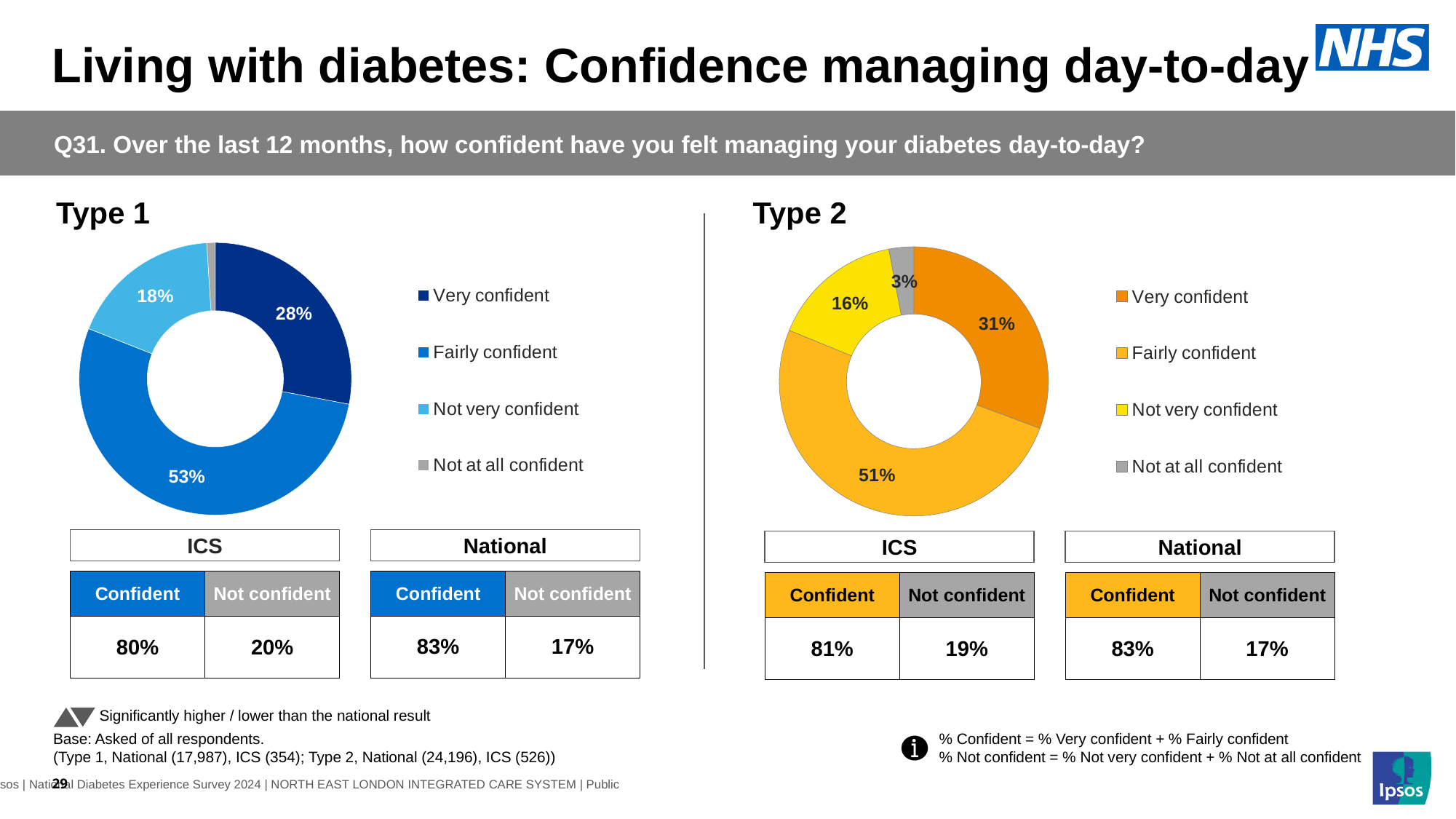
In the Type 1 chart, which category has the largest share? Fairly confident How many categories does the legend of the Type 1 chart list? 4 In the Type 1 chart, what percentage of respondents were Fairly confident? 53% In the Type 2 chart, what percentage of respondents were Not very confident? 16% In the Type 1 chart, what is the difference between the Fairly confident and Very confident shares? 25 percentage points In the Type 2 chart, which category has the largest share? Fairly confident Is the Very confident share larger in the Type 1 chart or the Type 2 chart? Type 2 What kind of chart is used to show the Type 2 results? Doughnut (pie) chart In the Type 2 chart, which category has the smallest share? Not at all confident In the Type 2 chart, what is the difference between the Very confident and Not very confident shares? 15 percentage points In the Type 1 chart, what percentage of respondents were Very confident? 28% In the Type 2 chart, what percentage of respondents were Not at all confident? 3%